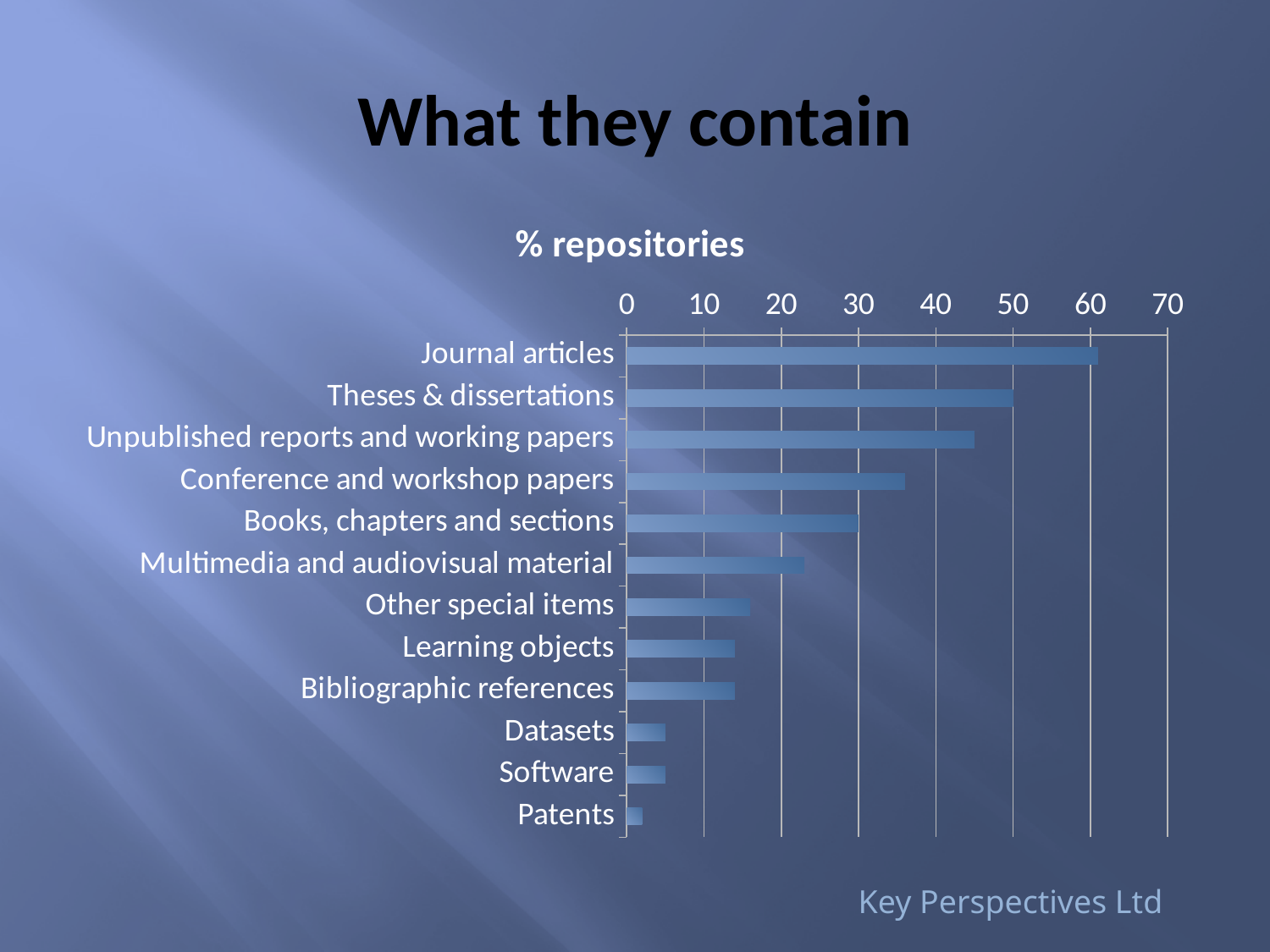
Which has a larger value, Theses & dissertations or Conference and workshop papers? Theses & dissertations Which has a larger value, Other special items or Patents? Other special items How many categories are plotted in the chart? 12 Is the value for Datasets greater or less than 10? less Is the value for Conference and workshop papers greater or less than 40? less What kind of chart is shown on the slide? bar chart Is the value for Multimedia and audiovisual material greater or less than 20? greater Which category has the lowest value? Patents Which category has the highest value? Journal articles What is the title of the chart? % repositories